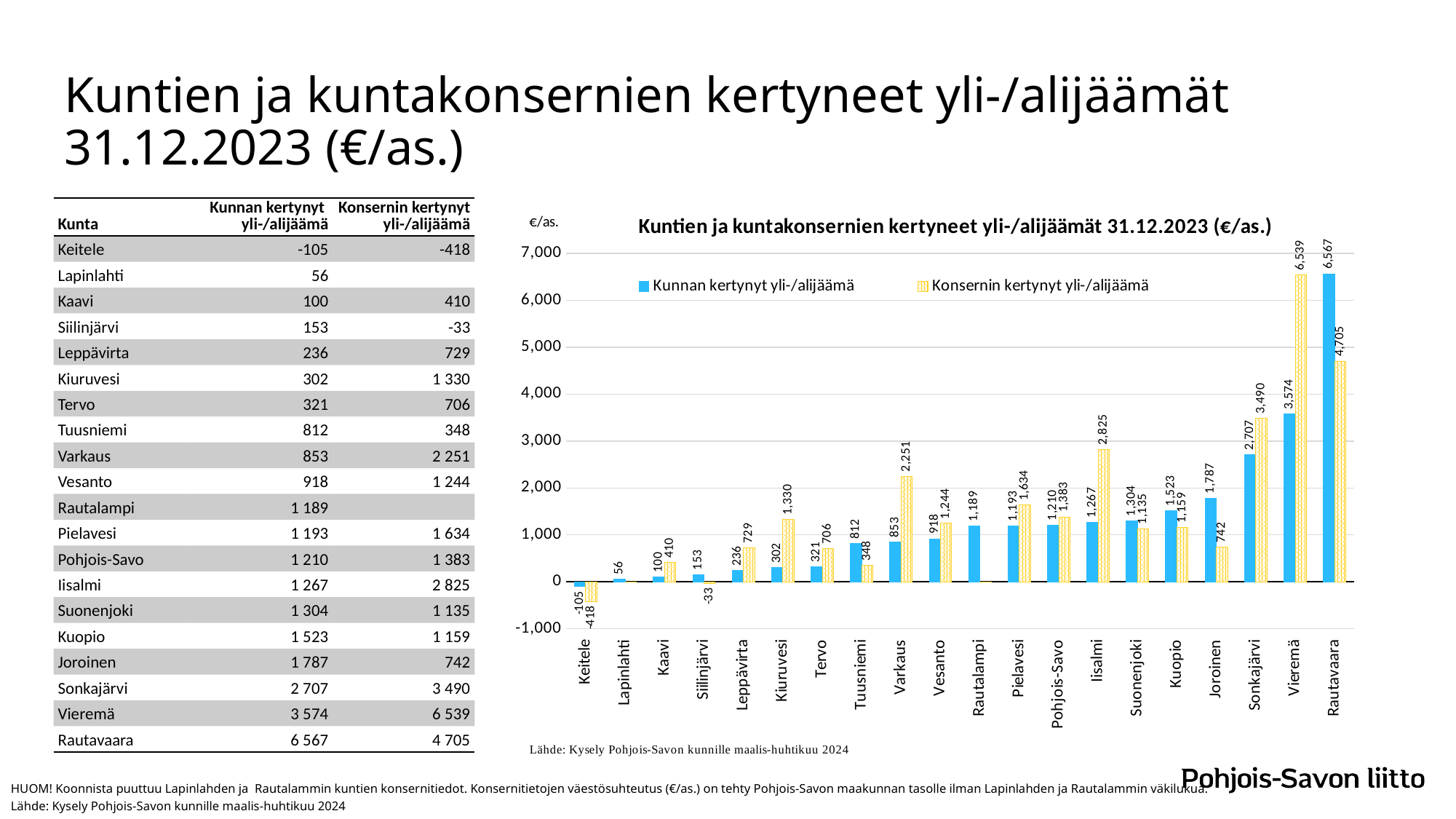
Which municipality has the highest Kunnan kertynyt yli-/alijäämä value on the chart? Rautavaara What is the Kunnan kertynyt yli-/alijäämä value for Rautavaara on the chart? 6,567 How many municipalities (categories) are shown on the chart's x axis? 20 What type of chart is shown on the slide? bar chart Which municipality has the lowest Konsernin kertynyt yli-/alijäämä value on the chart? Keitele Which colour represents the Kunnan kertynyt yli-/alijäämä series on the chart? blue What is the Konsernin kertynyt yli-/alijäämä value for Vieremä on the chart? 6,539 What is the difference between the Konsernin and Kunnan kertynyt yli-/alijäämä values for Iisalmi on the chart? 1,558 What is the Konsernin kertynyt yli-/alijäämä value for Keitele on the chart? -418 How many series does the chart legend list? 2 Is the Konsernin kertynyt yli-/alijäämä value for Sonkajärvi greater or less than 3,000 on the chart? greater For Joroinen, which is larger on the chart: the Kunnan kertynyt yli-/alijäämä or the Konsernin kertynyt yli-/alijäämä? Kunnan kertynyt yli-/alijäämä